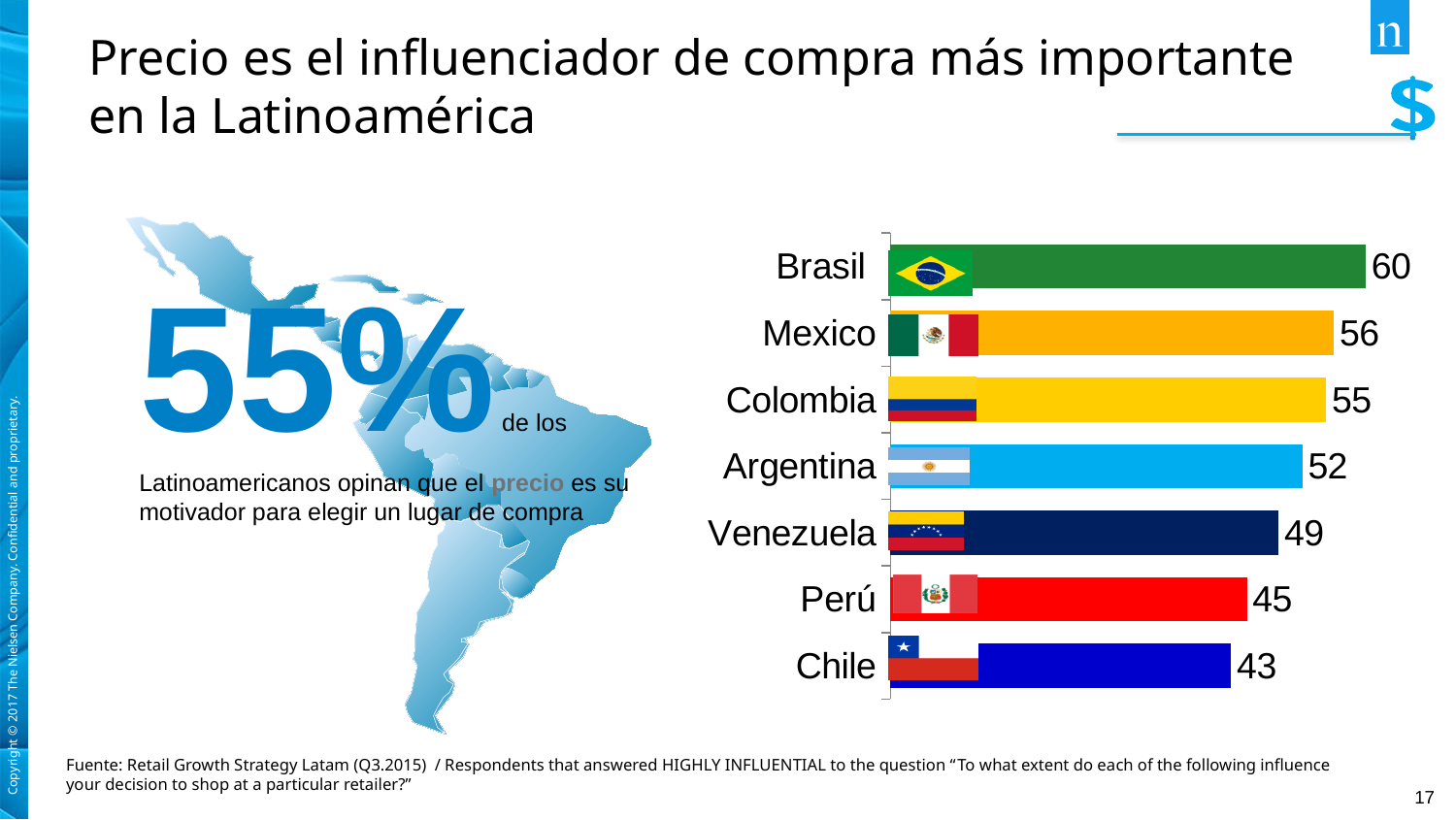
What kind of chart is shown on the slide? bar chart What is the value for Argentina? 52 What is the difference between the values for Mexico and Argentina? 4 What is the difference between the values for Brasil and Chile? 17 Which has a larger value, Colombia or Perú? Colombia Which country has the highest value? Brasil Do the values rise or fall going from Brasil at the top to Chile at the bottom? fall How many countries are shown in the chart? 7 What is the value for Brasil? 60 What is the value for Venezuela? 49 What is the value for Chile? 43 Which country has the lowest value? Chile